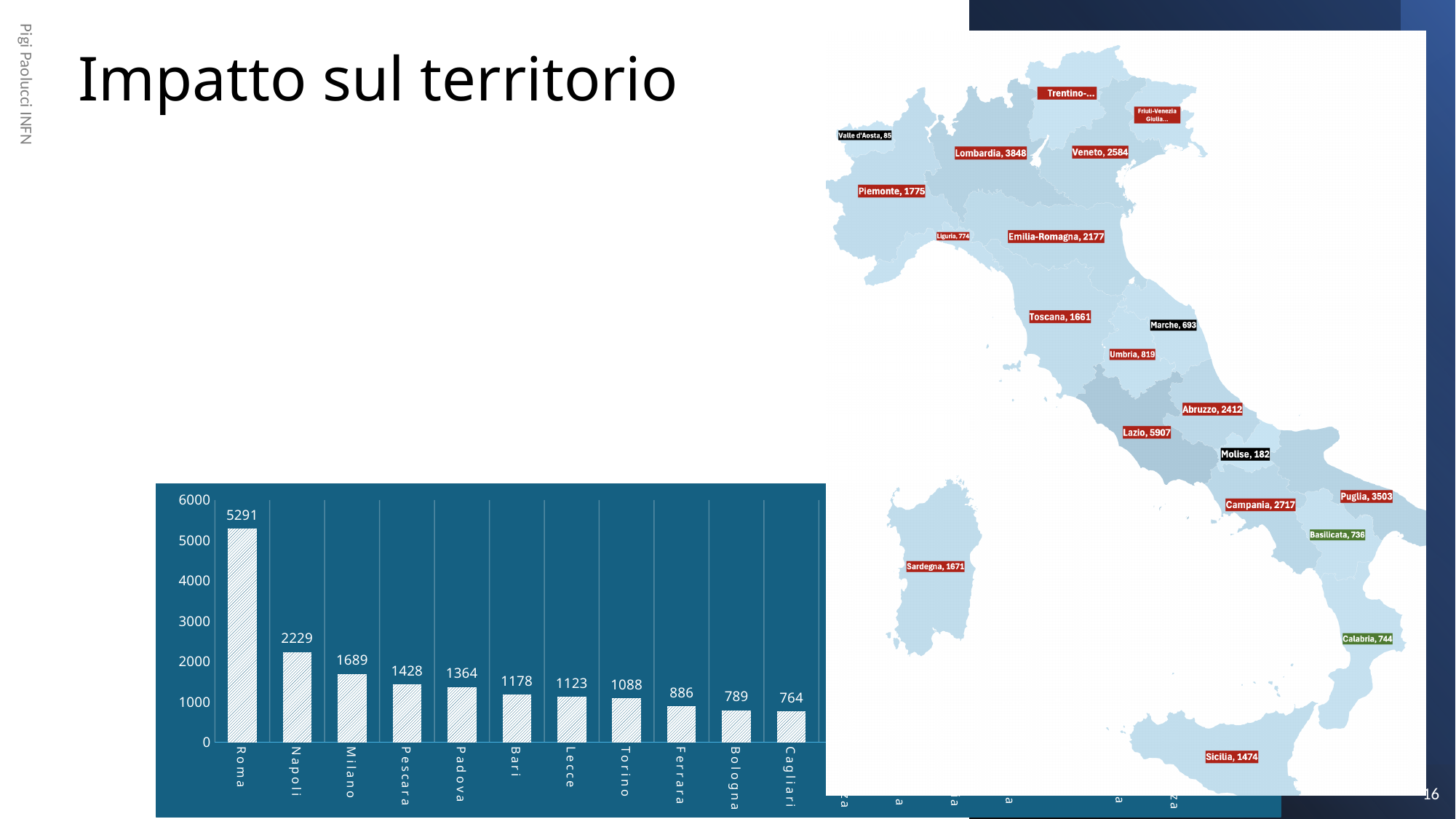
What kind of chart is shown at the bottom left of the slide? bar chart In the bar chart at the bottom left, is the value for Milano greater or less than 2000? less In the bar chart at the bottom left, which has a larger value, Bari or Torino? Bari On the map of Italy, what is the value shown for Lazio? 5907 In the bar chart at the bottom left, what is the value for Roma? 5291 On the map of Italy, what is the difference between the values for Lombardia and Veneto? 1264 On the map of Italy, what is the value shown for Puglia? 3503 In the bar chart at the bottom left, which city has the highest value? Roma In the bar chart at the bottom left, do the values rise or fall from Roma to Cagliari? fall On the map of Italy, which region has the lowest value shown? Valle d'Aosta In the bar chart at the bottom left, what is the value for Padova? 1364 In the bar chart at the bottom left, what is the difference between the values for Roma and Napoli? 3062